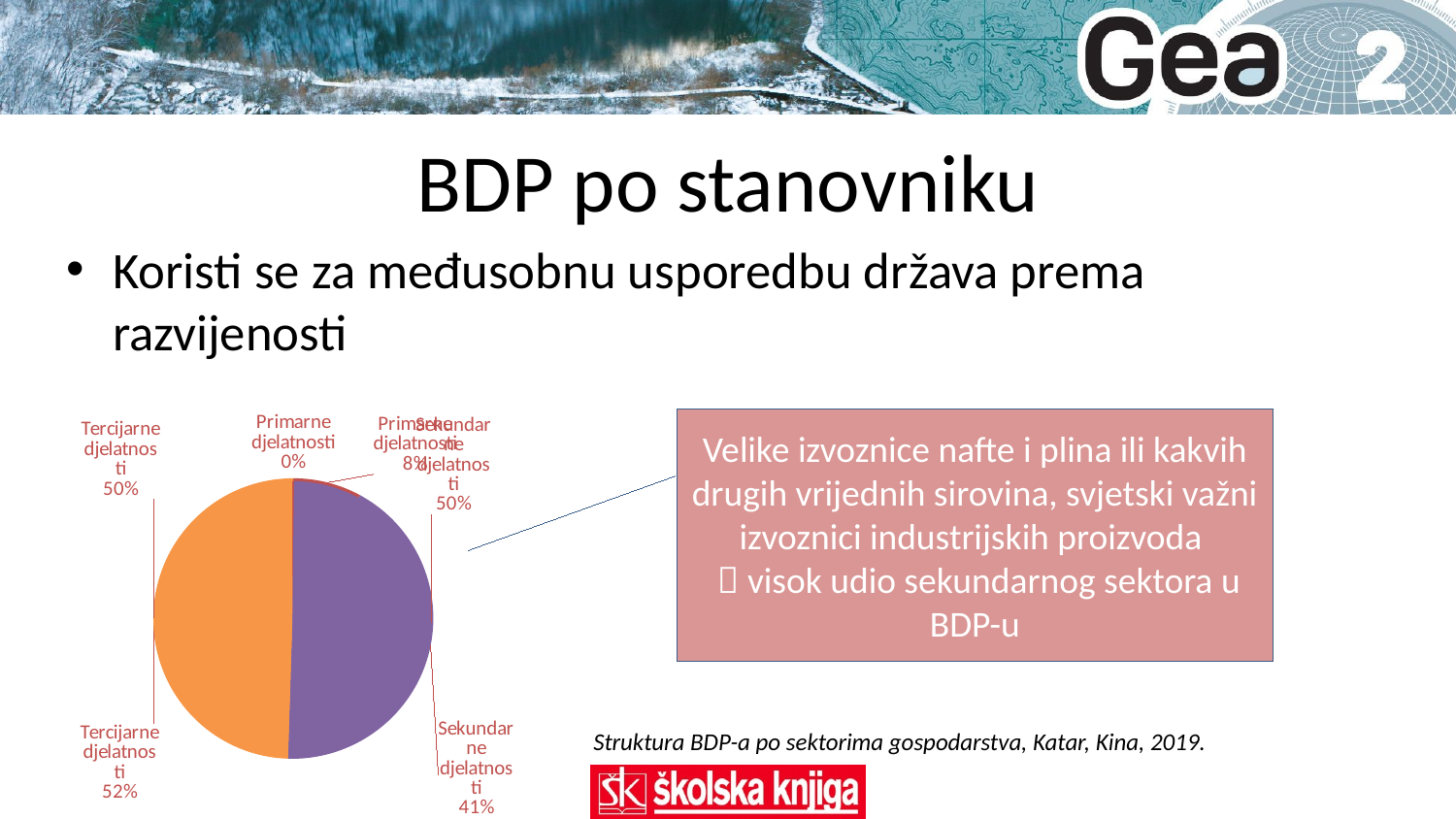
What percentage is shown in the Sekundarne djelatnosti label at the bottom right of the chart? 41% What percentage is shown in the Tercijarne djelatnosti label at the bottom left of the chart? 52% What percentage is shown in the Tercijarne djelatnosti label at the top left of the chart? 50% What is the difference between the Tercijarne djelatnosti label of 52% and the Sekundarne djelatnosti label of 41%? 11% What is the caption printed below the chart? Struktura BDP-a po sektorima gospodarstva, Katar, Kina, 2019. Is the share labelled for Sekundarne djelatnosti at the bottom right (41%) greater or less than 50%? less Which two colours are used for the visible slices of the pie? orange and purple Which is larger according to the bottom labels: Tercijarne djelatnosti (52%) or Sekundarne djelatnosti (41%)? Tercijarne djelatnosti What percentage is shown in the data label for Primarne djelatnosti at the top of the chart? 0% Which sector has the smallest share according to the labels on the chart? Primarne djelatnosti What kind of chart is shown on the slide? pie chart